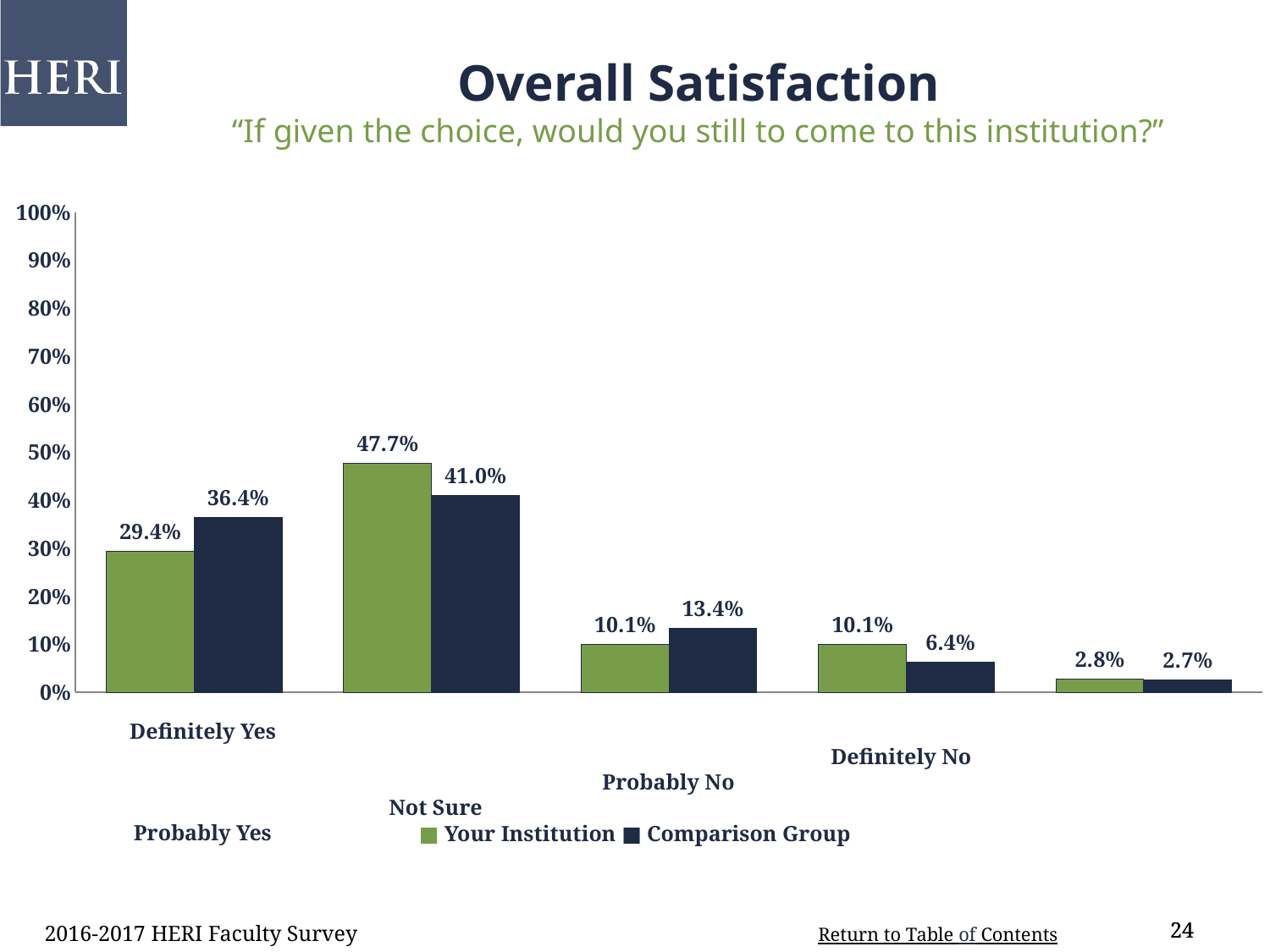
What is the highest value shown for Your Institution? 47.7% What colour represents Your Institution in the legend? Green How many series does the legend list? 2 How many groups of bars are plotted on the chart? 5 In the Definitely Yes category, how much higher is the Comparison Group value than the Your Institution value? 7.0 percentage points What is the value for the Comparison Group in the Definitely Yes category? 36.4% What is the lowest value shown for the Comparison Group? 2.7% What is the value for Your Institution in the Definitely Yes category? 29.4% What kind of chart is shown on the slide? Bar chart In the second group of bars from the left, what is the difference between the Your Institution value (47.7%) and the Comparison Group value (41.0%)? 6.7 percentage points In the fourth group of bars from the left, which series has the larger value? Your Institution In the Definitely Yes category, which series has the larger value, Your Institution or Comparison Group? Comparison Group